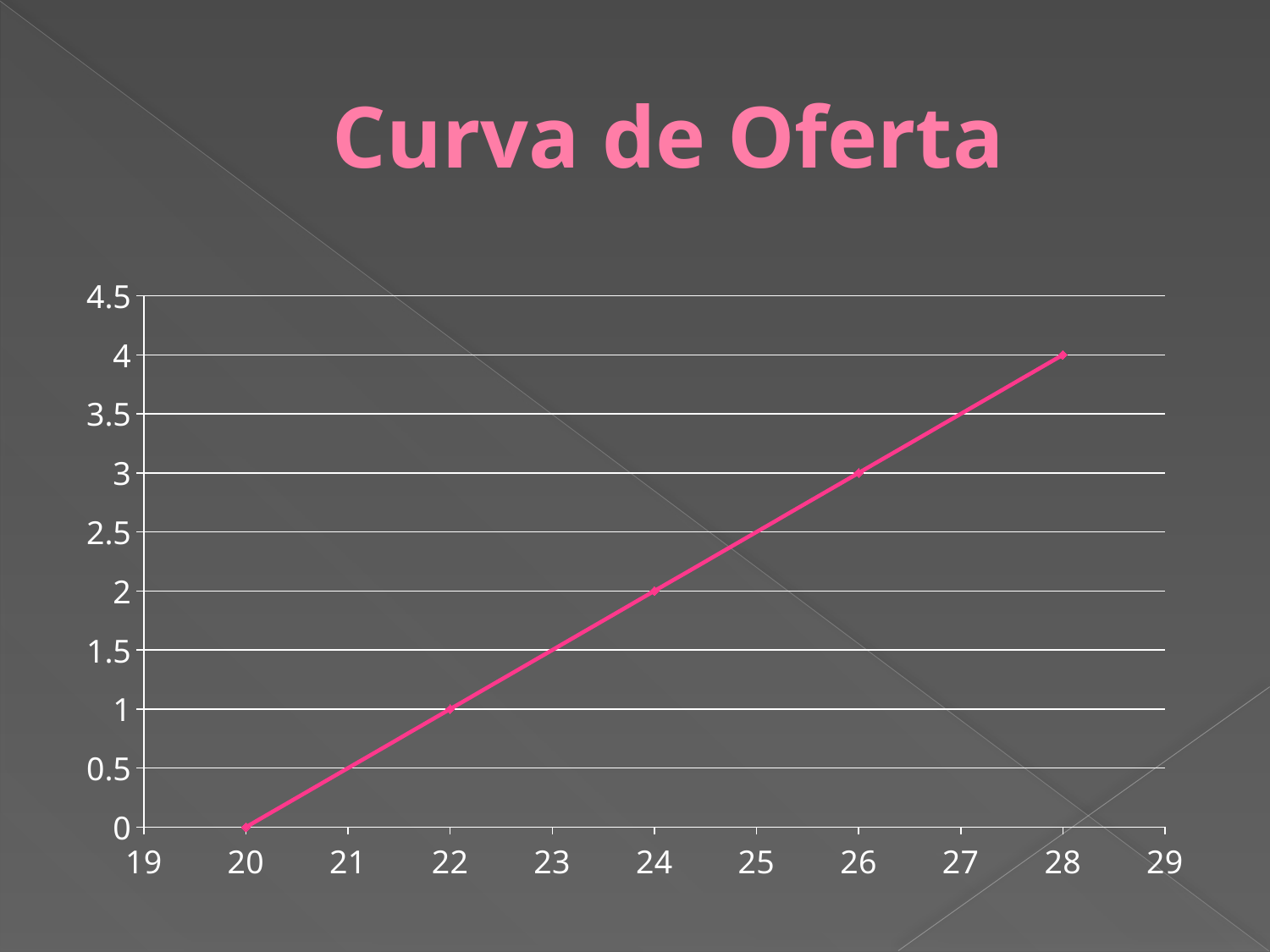
Do the values rise or fall as the x axis increases from 20 to 28? rise What is the y value at x = 20? 0 Which is larger, the y value at x = 26 or the y value at x = 24? x = 26 What is the difference between the y value at x = 28 and the y value at x = 22? 3 What is the y value at x = 22? 1 What is the y value at x = 24? 2 At which x value is the plotted y value highest? 28 What is the y value at x = 28? 4 What is the title of the chart? Curva de Oferta How many data points are plotted on the line? 5 At which x value is the plotted y value lowest? 20 What kind of chart is shown on the slide? line chart